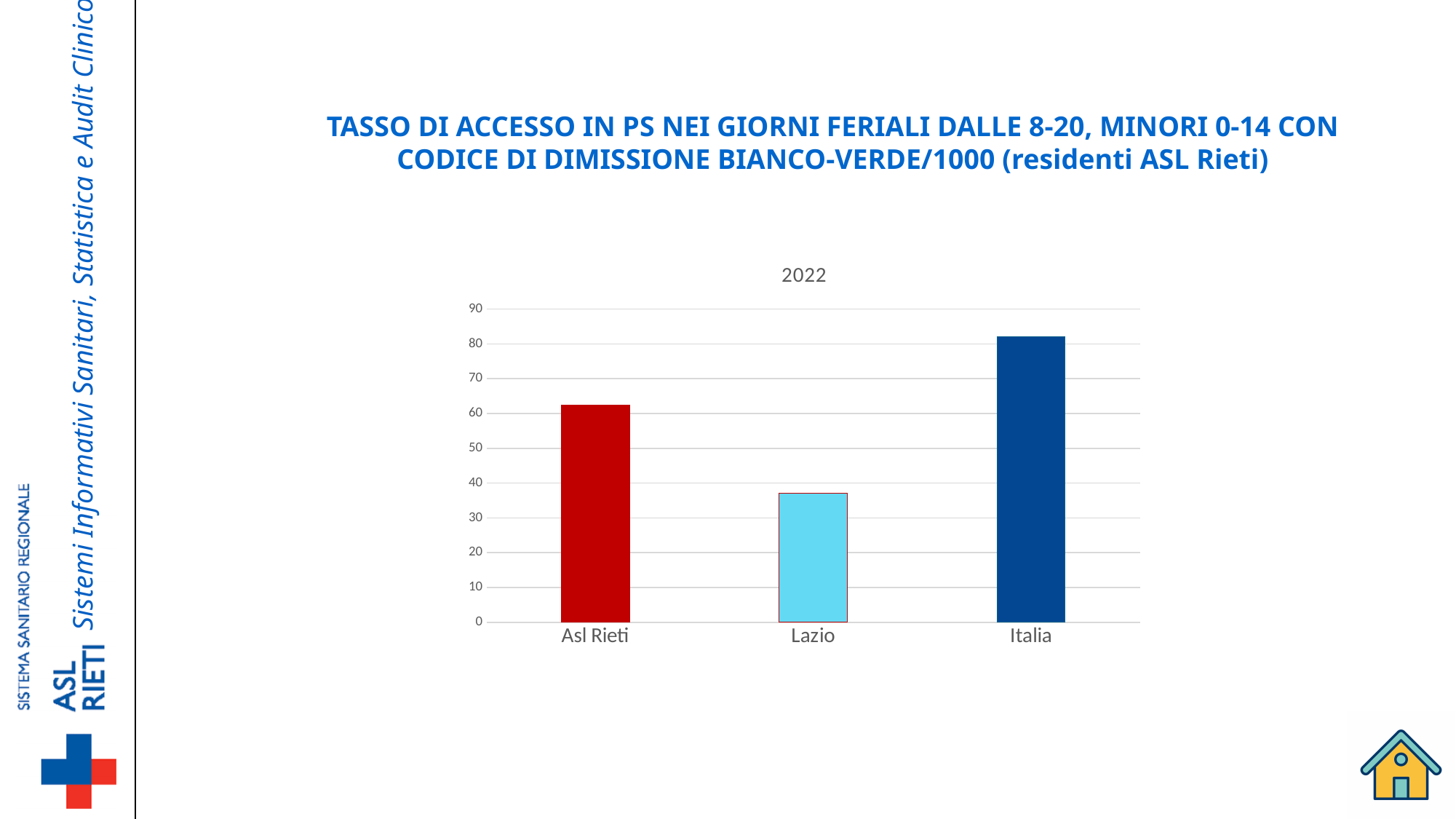
How many categories are plotted in the chart? 3 Which is larger, the value for Asl Rieti or the value for Lazio? Asl Rieti Which is larger, the value for Italia or the value for Asl Rieti? Italia What is the title shown directly above the chart's plot area? 2022 What colour is the bar for Lazio? light blue What is the highest value shown on the vertical axis? 90 Which category has the highest value in the chart? Italia Is the value for Asl Rieti greater or less than 60? greater Which category has the lowest value in the chart? Lazio Is the value for Lazio greater or less than 40? less Is the value for Italia greater or less than 80? greater What kind of chart is shown on the slide? bar chart